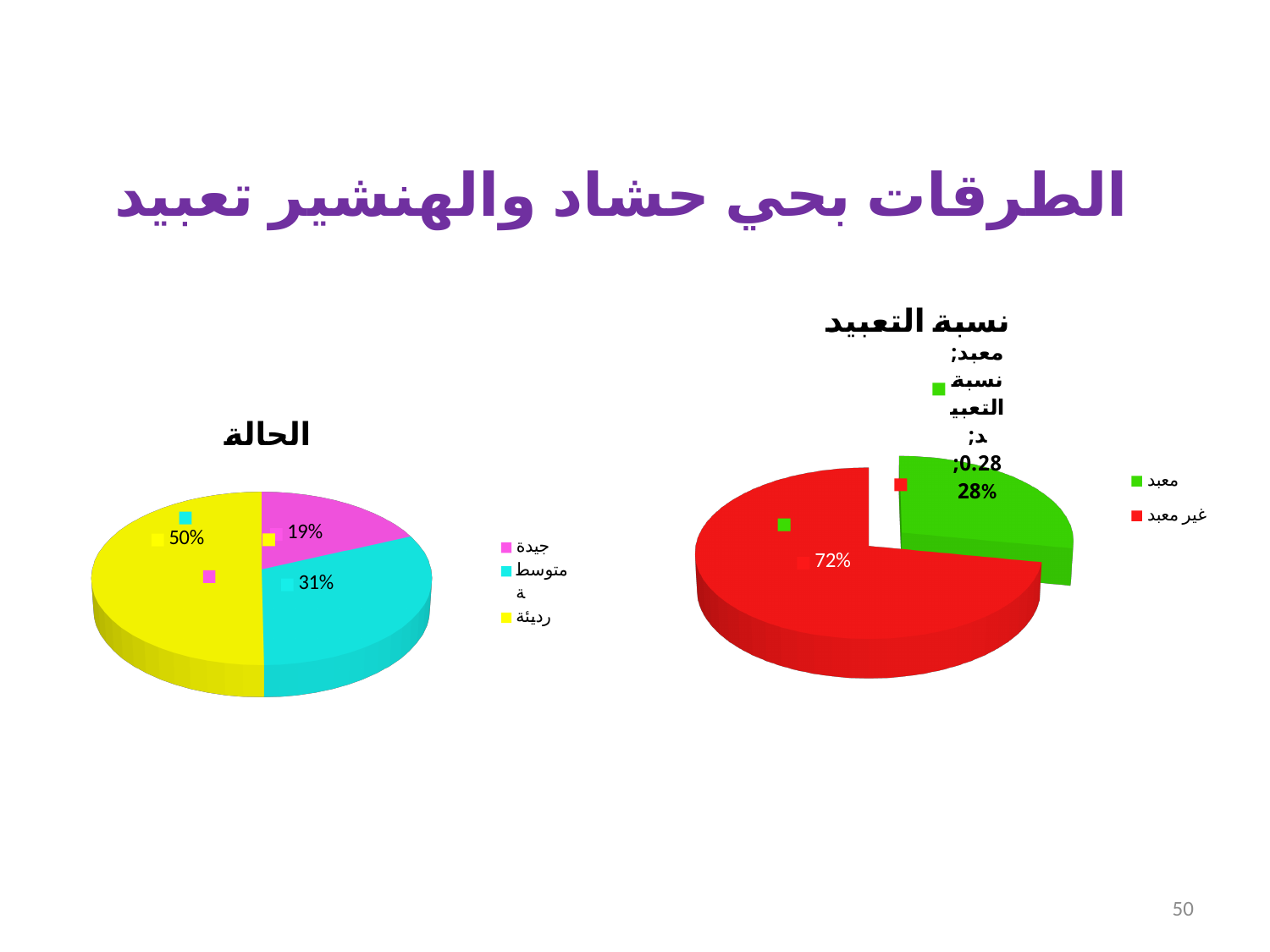
In the chart titled الحالة, which category has the smallest slice? جيدة In the chart titled نسبة التعبيد, what is the value for غير معبد? 72% In the chart titled الحالة, what is the value for جيدة? 19% In the chart titled الحالة, what is the value for رديئة? 50% What kind of chart is the chart titled نسبة التعبيد? pie chart In the chart titled نسبة التعبيد, what is the difference between the values for غير معبد and معبد? 44% In the chart titled الحالة, which category has the largest slice? رديئة In the chart titled الحالة, what is the value for متوسطة? 31% In the chart titled الحالة, what is the difference between the values for رديئة and متوسطة? 19% In the chart titled الحالة, how many categories are shown? 3 In the chart titled نسبة التعبيد, what is the value for معبد? 28% In the chart titled نسبة التعبيد, which is larger, معبد or غير معبد? غير معبد